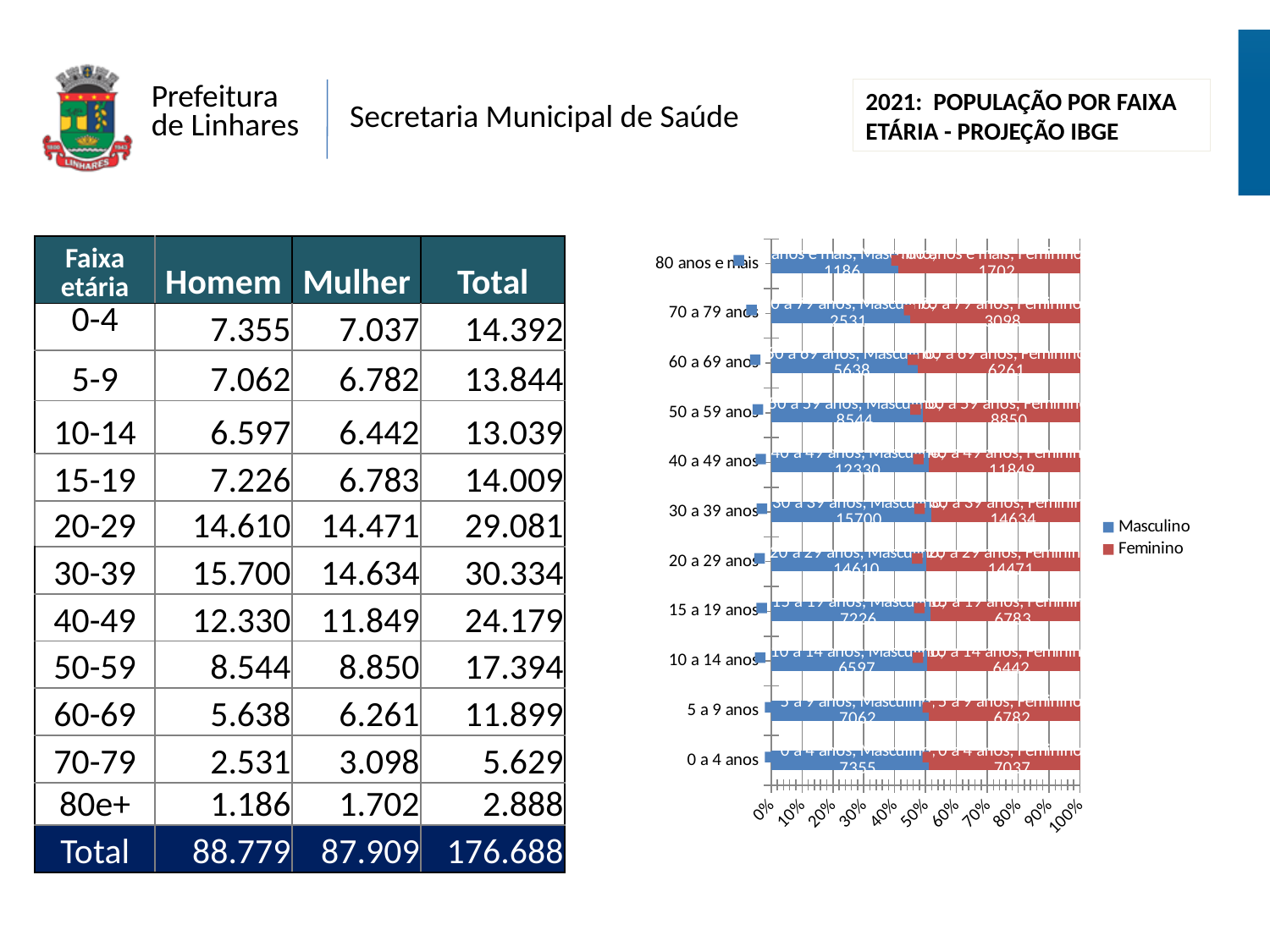
How many age-group categories are plotted on the chart? 11 Which colour represents the Feminino series in the chart? Red How many series does the chart's legend list? 2 What is the Feminino value labelled on the chart for '70 a 79 anos'? 3098 On the chart, is the Masculino share of the '80 anos e mais' bar greater or less than 50%? less Which age group has the highest Masculino value on the chart? 30 a 39 anos Which age group has the lowest Masculino value on the chart? 80 anos e mais On the chart, what is the difference between the Feminino and Masculino values for '80 anos e mais'? 516 What kind of chart is shown on the slide? Stacked bar chart What is the Masculino value labelled on the chart for '80 anos e mais'? 1186 What is the maximum value shown on the chart's horizontal axis? 100% For '60 a 69 anos', which is larger on the chart, Masculino or Feminino? Feminino